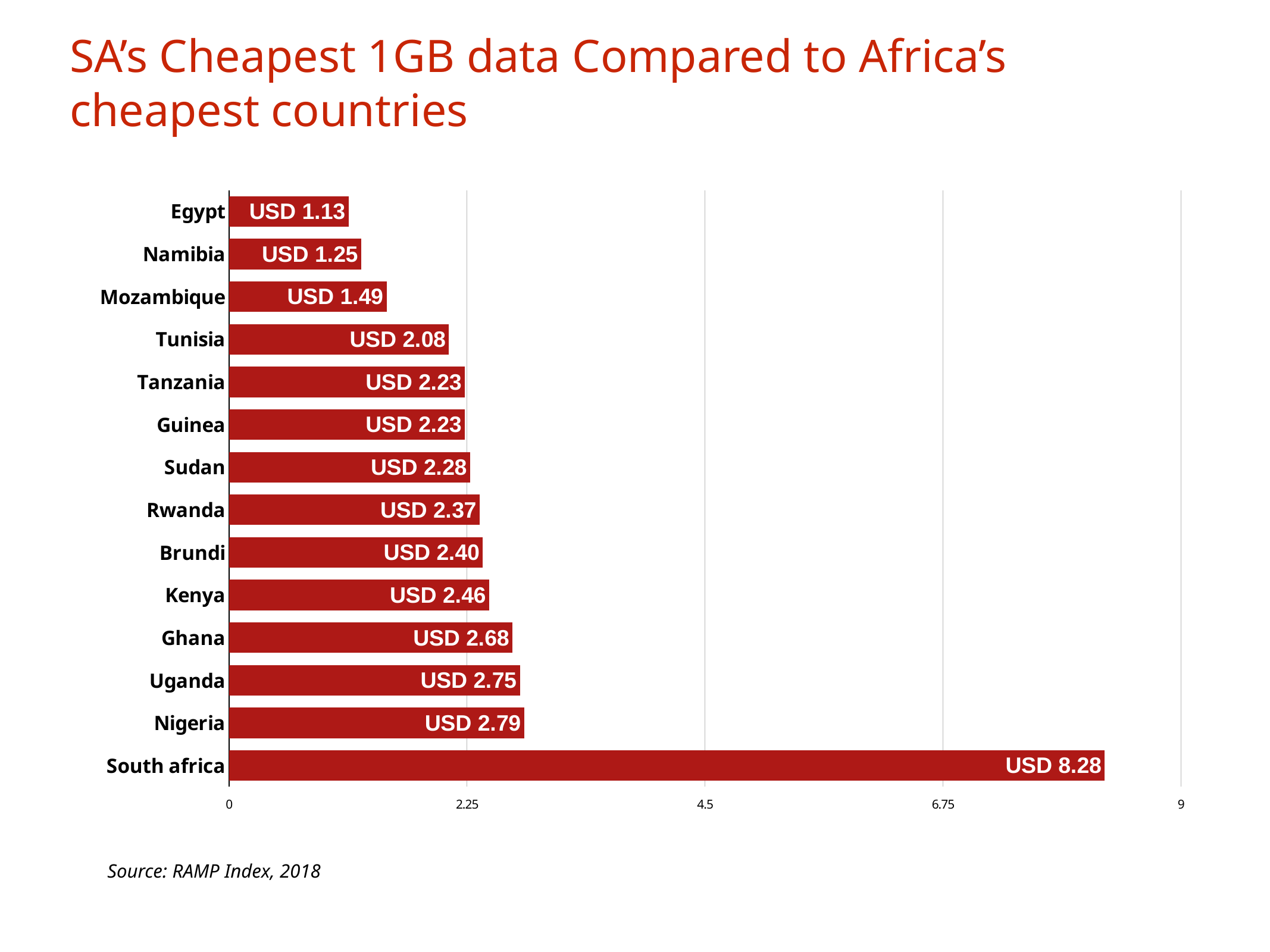
Which country has the lowest 1GB data price on the chart? Egypt What is the value shown for Kenya? USD 2.46 What kind of chart is shown on the slide? Bar chart What is the value shown for South africa? USD 8.28 Is the value for South africa greater or less than 6.75? greater Which has a higher value, Ghana or Tunisia? Ghana How many countries are shown on the chart? 14 What is the difference between the values for South africa and Nigeria? USD 5.49 Which country has the highest 1GB data price on the chart? South africa What is the difference between the values for Namibia and Egypt? USD 0.12 What is the source cited for the chart? RAMP Index, 2018 What is the cheapest 1GB data price shown for Egypt? USD 1.13